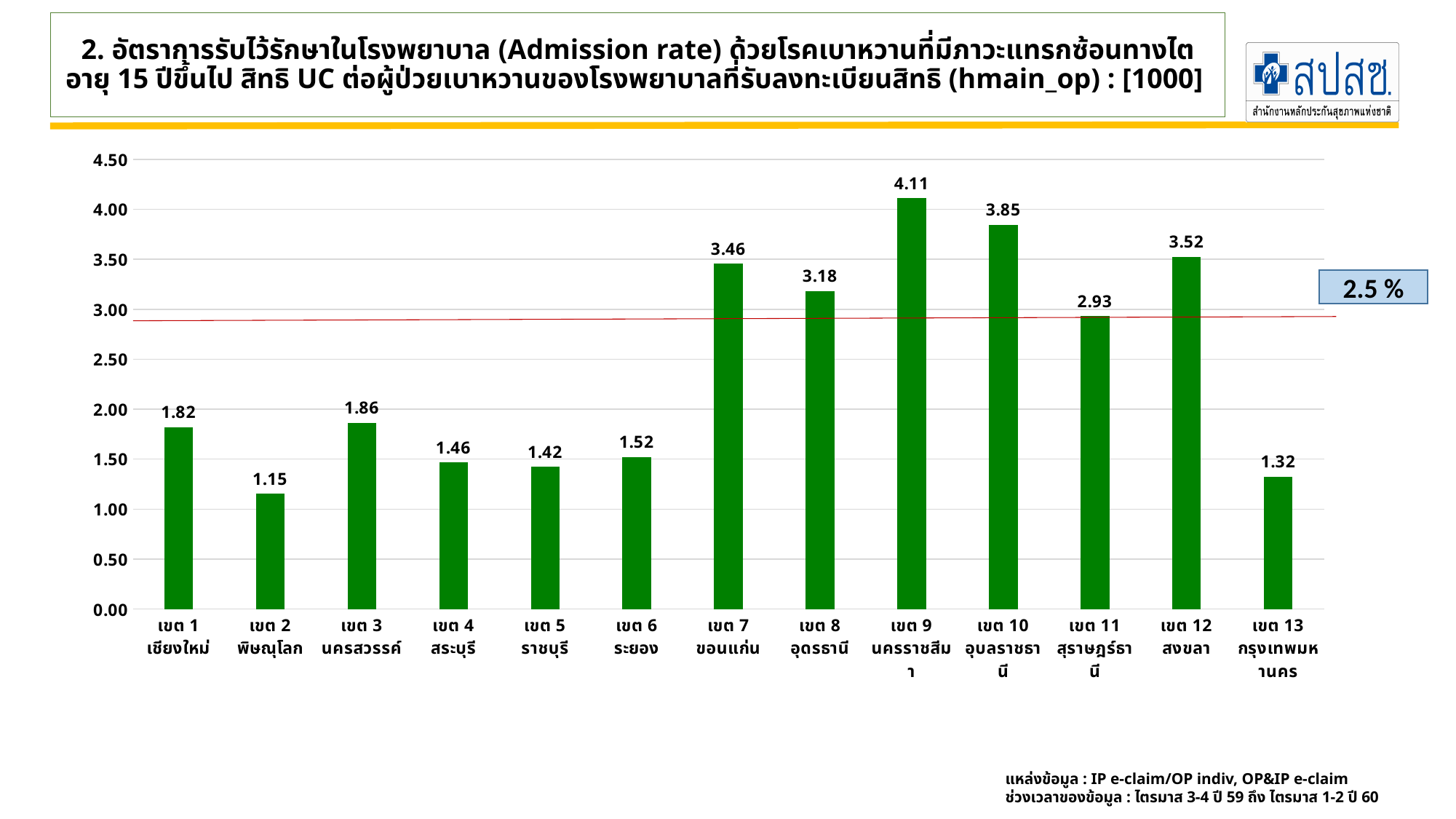
Which has a larger value, เขต 10 อุบลราชธานี or เขต 12 สงขลา? เขต 10 อุบลราชธานี Is the value for เขต 11 สุราษฎร์ธานี greater or less than 2.50? greater How many regions (เขต) are shown on the x axis? 13 Which region has the lowest admission rate? เขต 2 พิษณุโลก What percentage is shown in the box next to the red horizontal line? 2.5 % What kind of chart is shown on the slide? bar chart What is the difference between the values for เขต 9 นครราชสีมา and เขต 2 พิษณุโลก? 2.96 What is the value for เขต 13 กรุงเทพมหานคร? 1.32 What is the value for เขต 9 นครราชสีมา? 4.11 What is the value for เขต 2 พิษณุโลก? 1.15 What is the difference between the values for เขต 7 ขอนแก่น and เขต 8 อุดรธานี? 0.28 Which region has the highest admission rate? เขต 9 นครราชสีมา